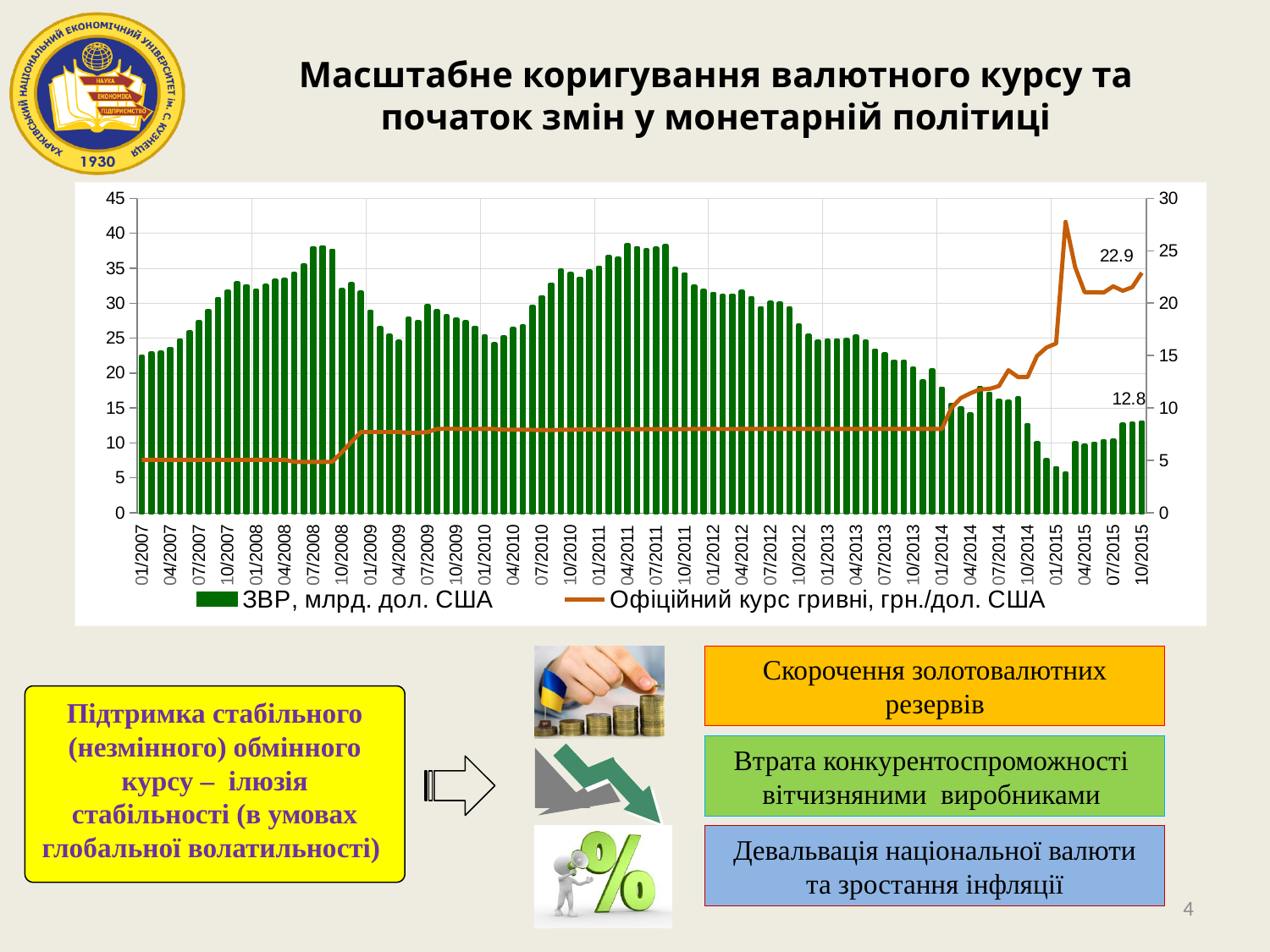
What is the labelled value of Офіційний курс гривні, грн./дол. США at the last point (10/2015)? 22.9 How many series does the chart legend list? 2 Does the Офіційний курс гривні line rise or fall overall from 01/2007 to 10/2015? rise Which is larger: ЗВР, млрд. дол. США in 07/2008 or in 10/2015? 07/2008 What is the labelled value of ЗВР, млрд. дол. США at the last point (10/2015)? 12.8 Is the peak value of the Офіційний курс гривні line in early 2015 greater or less than 25 on the right axis? greater Is the value of Офіційний курс гривні for 01/2007 greater or less than 10 on the right axis? less What are the two series named in the chart legend? ЗВР, млрд. дол. США and Офіційний курс гривні, грн./дол. США Is the value of ЗВР, млрд. дол. США for 07/2008 greater or less than 35? greater What kind of chart is shown on the slide? A combined bar and line chart